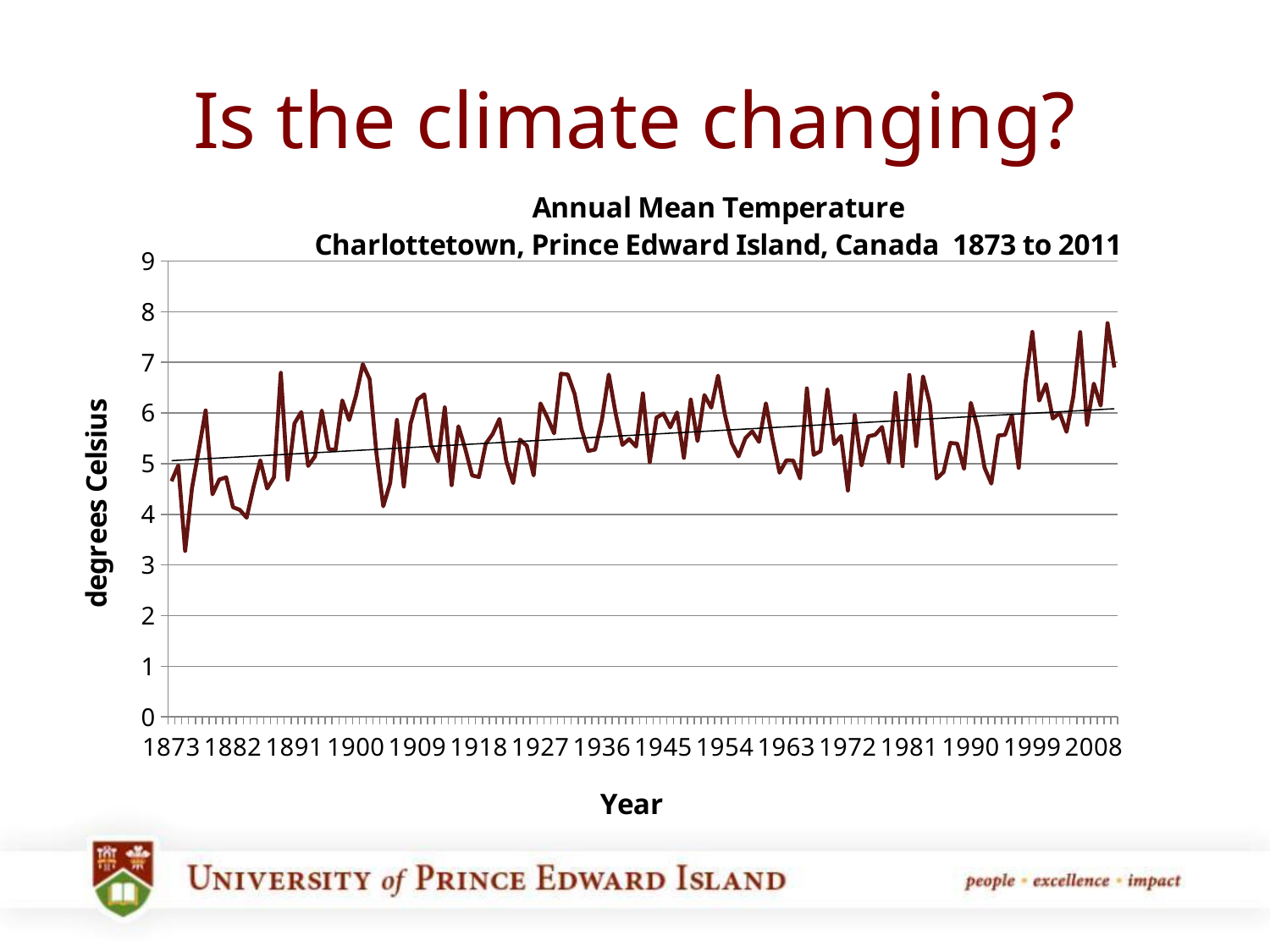
What kind of chart is shown on the slide? line chart What is the title of the chart? Annual Mean Temperature Charlottetown, Prince Edward Island, Canada 1873 to 2011 Is the value for 2008 greater or less than 6? greater Is the lowest annual mean temperature plotted on the chart greater or less than 4? less Is the value for 1873 greater or less than 6? less What is the label on the vertical axis of the chart? degrees Celsius What is the highest value shown on the vertical axis of the chart? 9 According to the trend line, do annual mean temperatures rise or fall from 1873 to 2011? rise Which is larger, the value for 1873 or the value for 2008? 2008